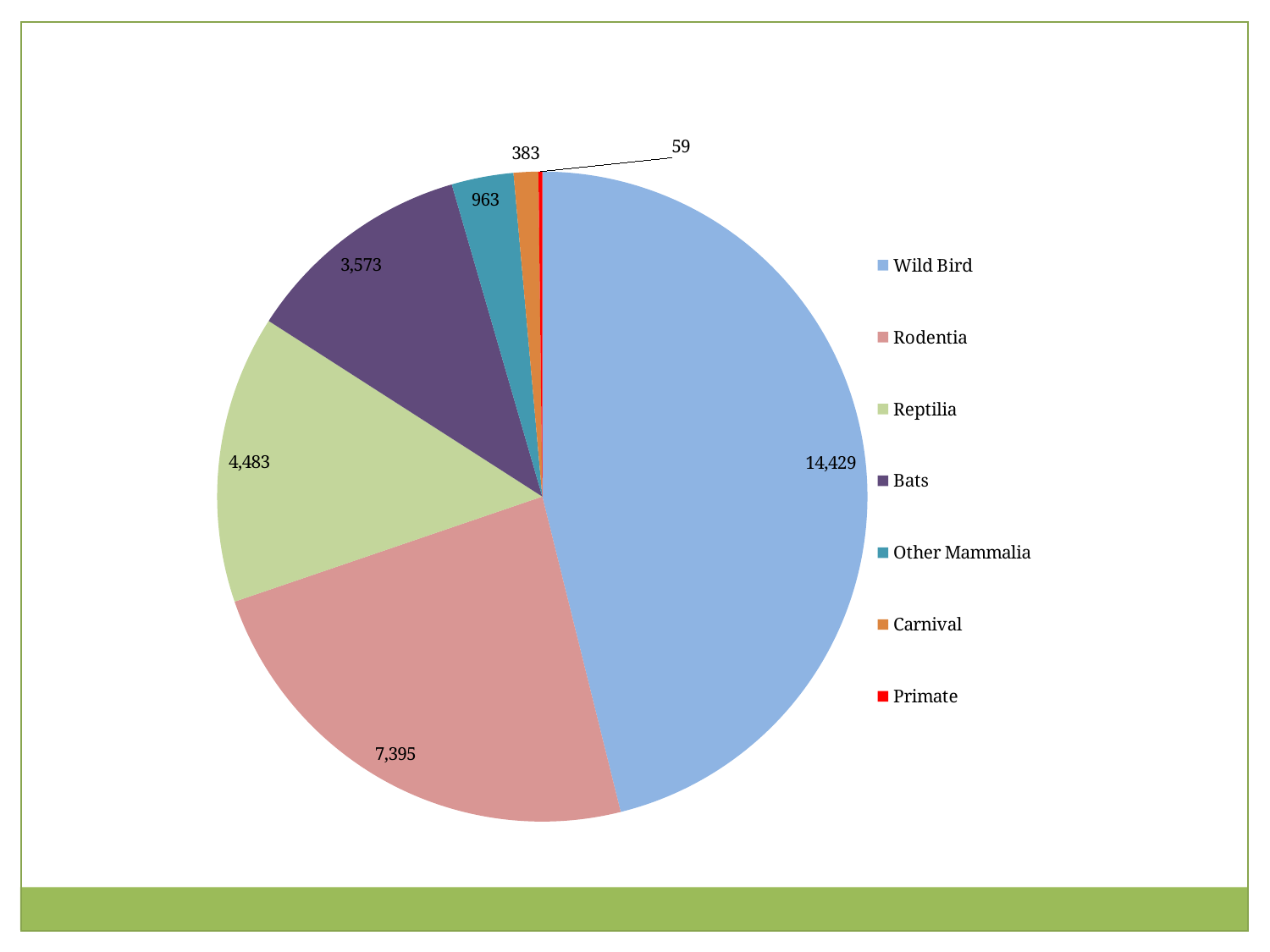
What is the difference between the Wild Bird value and the Rodentia value? 7,034 What is the difference between the Reptilia value and the Bats value? 910 Which category has the smallest slice in the pie chart? Primate Which category has the largest slice in the pie chart? Wild Bird What is the value for Primate in the pie chart? 59 What is the value for Wild Bird in the pie chart? 14,429 What is the value for Rodentia in the pie chart? 7,395 What is the value for Bats in the pie chart? 3,573 How many categories are shown in the pie chart? 7 What colour is the Primate slice in the pie chart? Red What kind of chart is shown on the slide? Pie chart Which is larger, the value for Other Mammalia or the value for Carnival? Other Mammalia